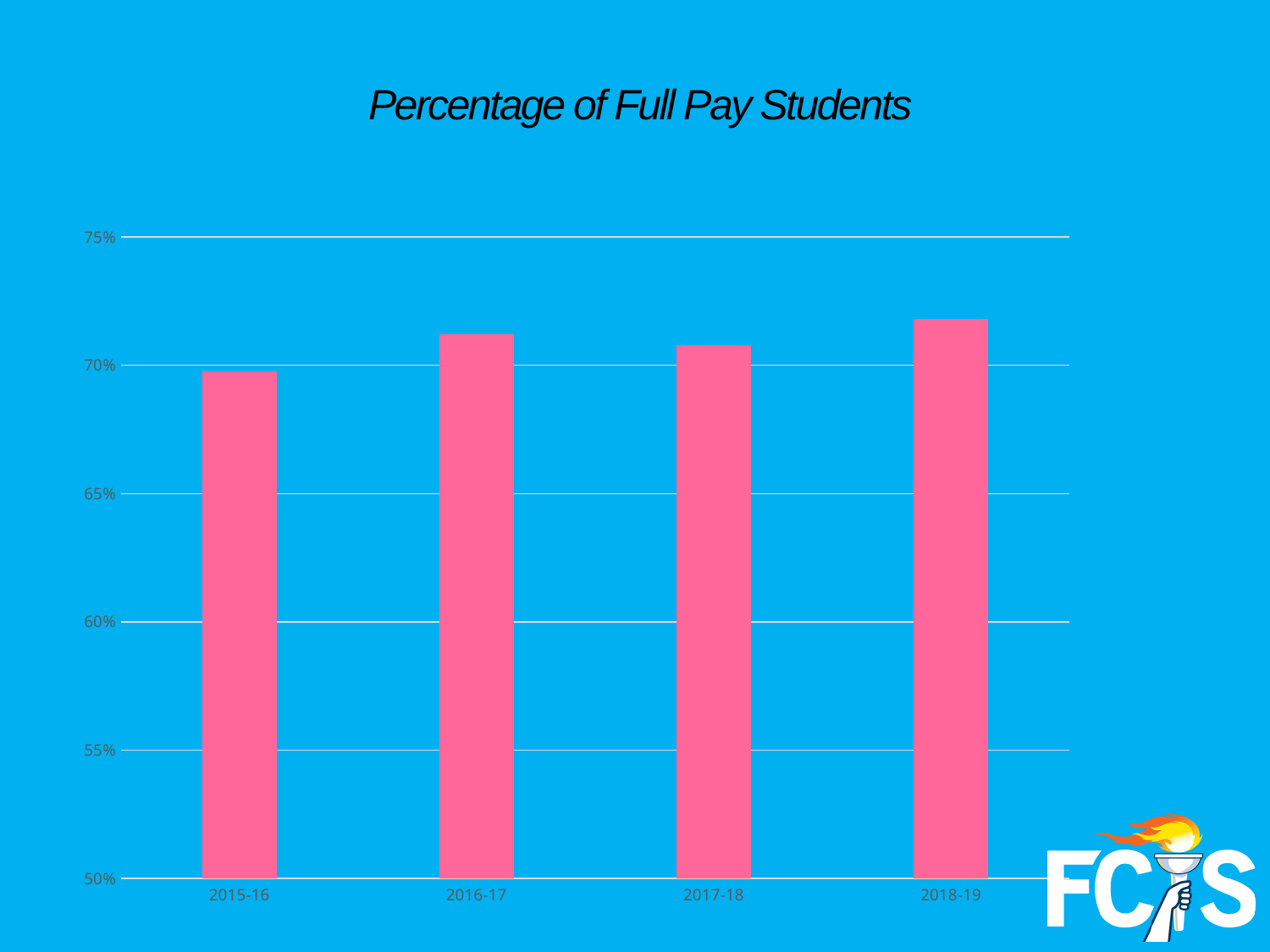
Is the value for 2015-16 greater or less than 65%? greater What is the title of the chart? Percentage of Full Pay Students Which school year has the highest percentage of full pay students? 2018-19 Is the value for 2016-17 greater or less than 70%? greater How many school years are shown on the x axis of the chart? 4 What kind of chart is shown on the slide? bar chart Is the value for 2018-19 greater or less than 75%? less What is the lowest value shown on the y axis of the chart? 50% Which school year has the lowest percentage of full pay students? 2015-16 Which is larger, the value for 2015-16 or the value for 2018-19? 2018-19 Which is larger, the value for 2016-17 or the value for 2015-16? 2016-17